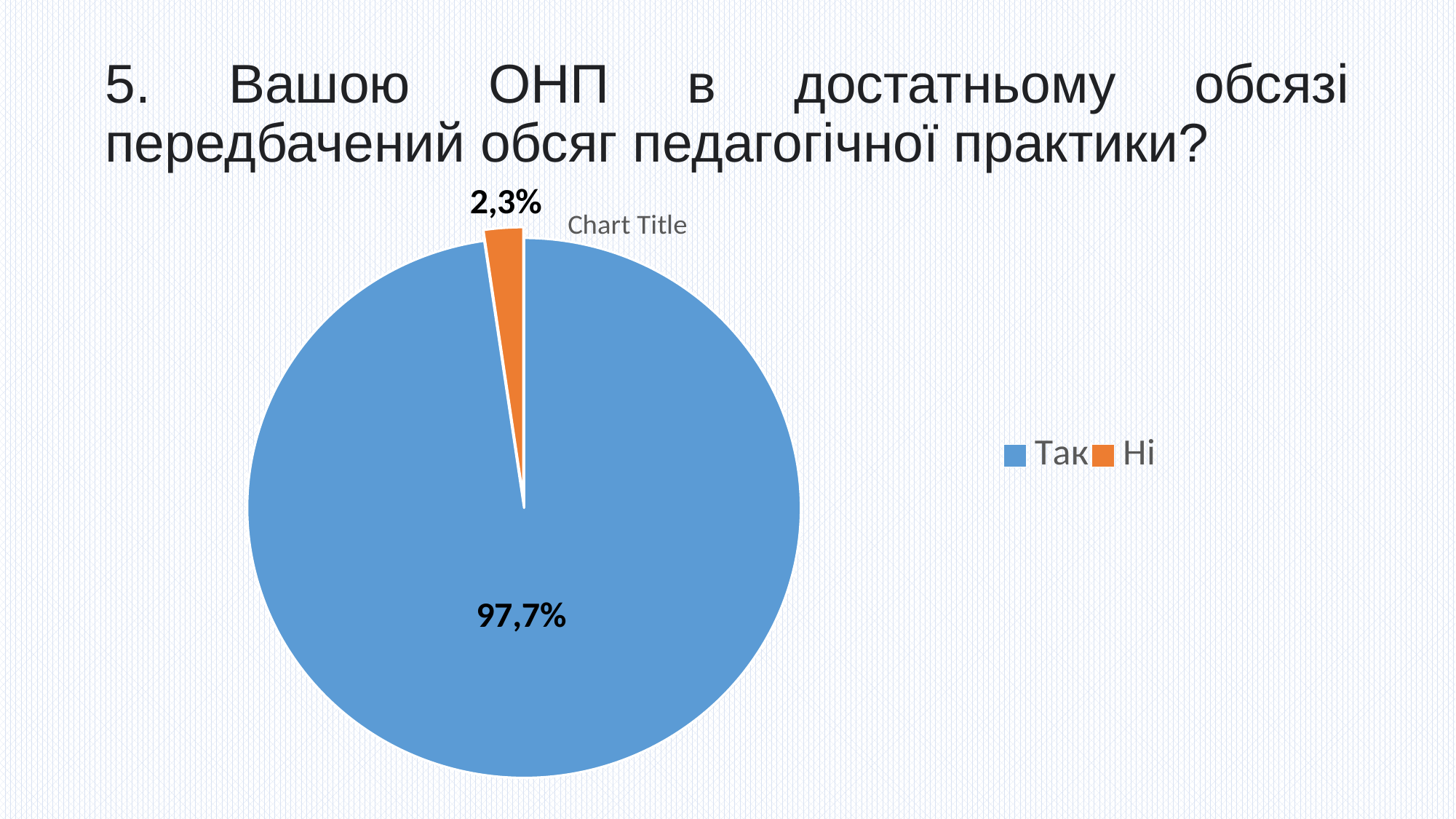
What is the title shown on the chart itself? Chart Title What share of the pie does "Так" represent? 97,7% How many slices does the pie chart have? 2 What kind of chart is shown on the slide? pie chart Which is larger, the share for "Так" or the share for "Ні"? Так Which category has the smallest slice of the pie? Ні What is the difference between the shares for "Так" and "Ні"? 95,4% What colour is the slice for "Ні"? orange How many entries does the legend list? 2 Which category has the largest slice of the pie? Так What share of the pie does "Ні" represent? 2,3%